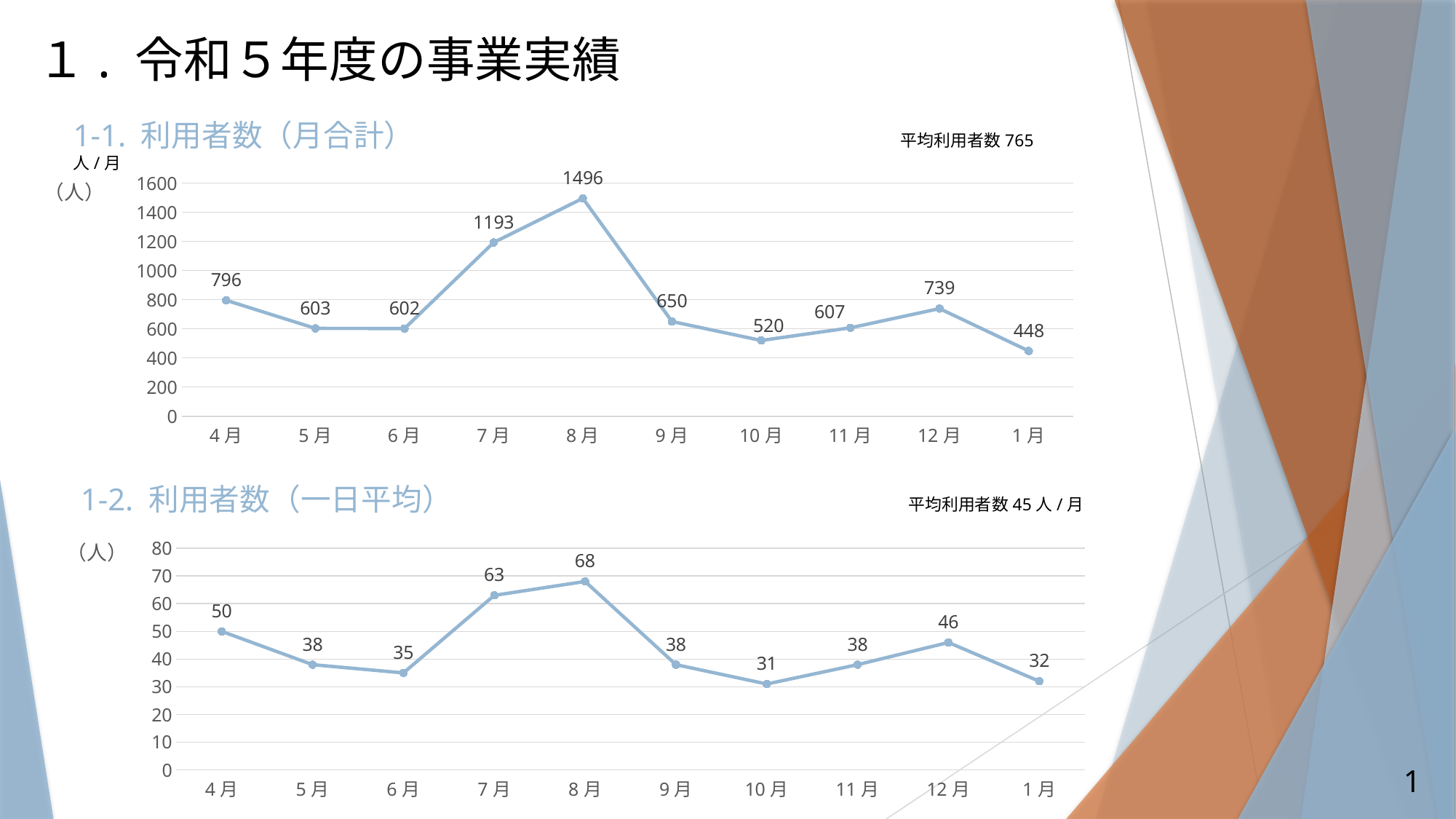
In the 1-2. 利用者数（一日平均） chart, what is the difference between the values for 4月 and 1月? 18 In the 1-2. 利用者数（一日平均） chart, do the values rise or fall from 8月 to 10月? fall In the 1-2. 利用者数（一日平均） chart, which month has the highest value? 8月 In the 1-1. 利用者数（月合計） chart, what is the difference between the values for 8月 and 7月? 303 In the 1-1. 利用者数（月合計） chart, which is larger, the value for 4月 or the value for 12月? 4月 What kind of chart is the 1-1. 利用者数（月合計） chart? line chart What average monthly user count is stated next to the 1-1. 利用者数（月合計） chart? 765 In the 1-1. 利用者数（月合計） chart, what is the value for 10月? 520 In the 1-1. 利用者数（月合計） chart, which month has the lowest value? 1月 In the 1-1. 利用者数（月合計） chart, how many months are plotted? 10 In the 1-1. 利用者数（月合計） chart, what is the value for 8月? 1496 In the 1-2. 利用者数（一日平均） chart, what is the value for 7月? 63